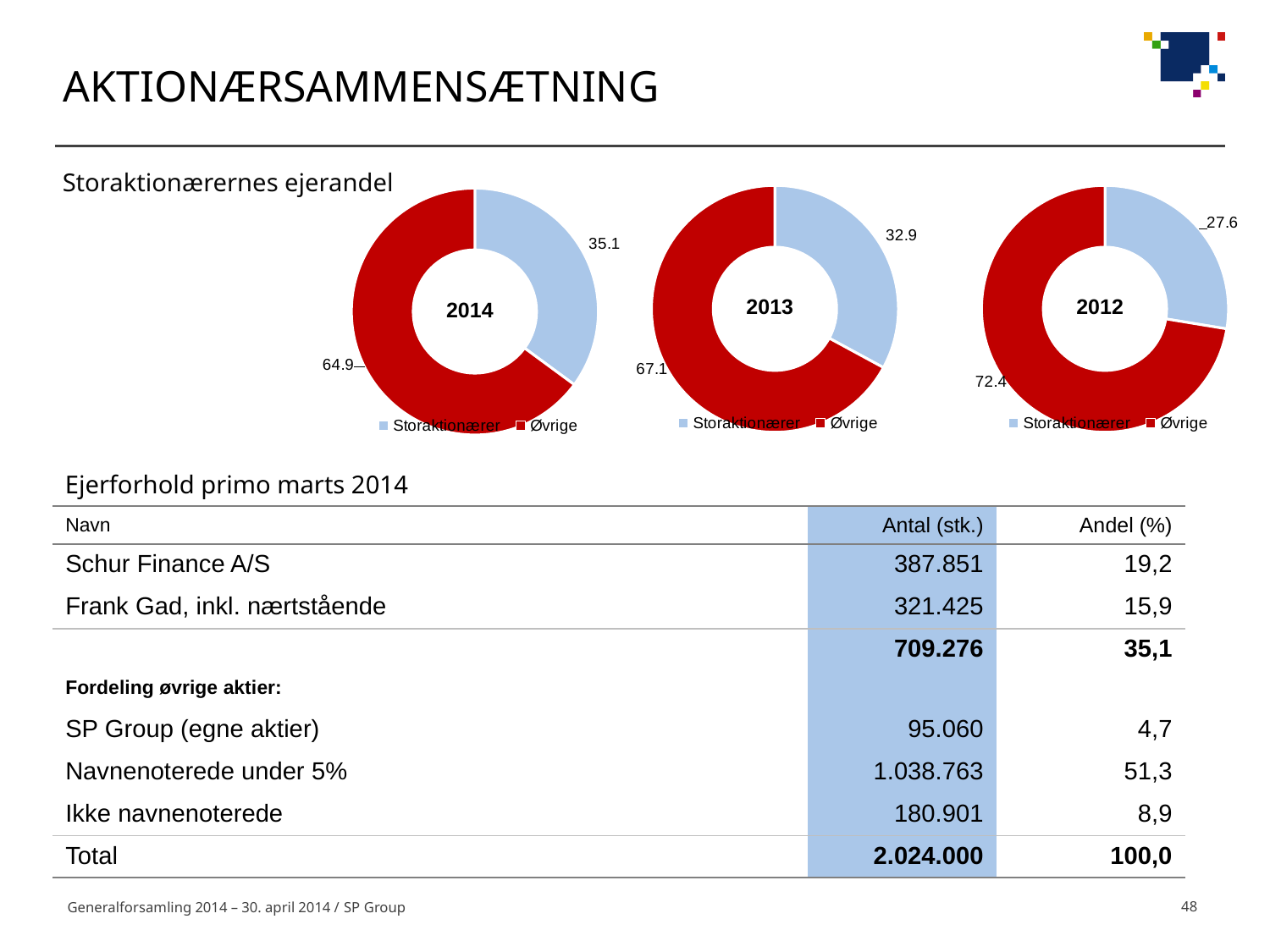
How many entries does the legend of the 2014 chart list? 2 How many slices does the 2013 chart have? 2 In the 2013 chart, which colour represents Øvrige? red In the 2014 chart, what is the value for Storaktionærer? 35.1 In the 2013 chart, what is the value for Øvrige? 67.1 What kind of chart is the 2012 chart? pie (donut) chart In the 2012 chart, what is the value for Storaktionærer? 27.6 In the 2013 chart, what is the value for Storaktionærer? 32.9 In the 2012 chart, what is the value for Øvrige? 72.4 In the 2012 chart, which slice is larger, Storaktionærer or Øvrige? Øvrige In the 2014 chart, what is the difference between Øvrige and Storaktionærer? 29.8 In the 2014 chart, what is the value for Øvrige? 64.9